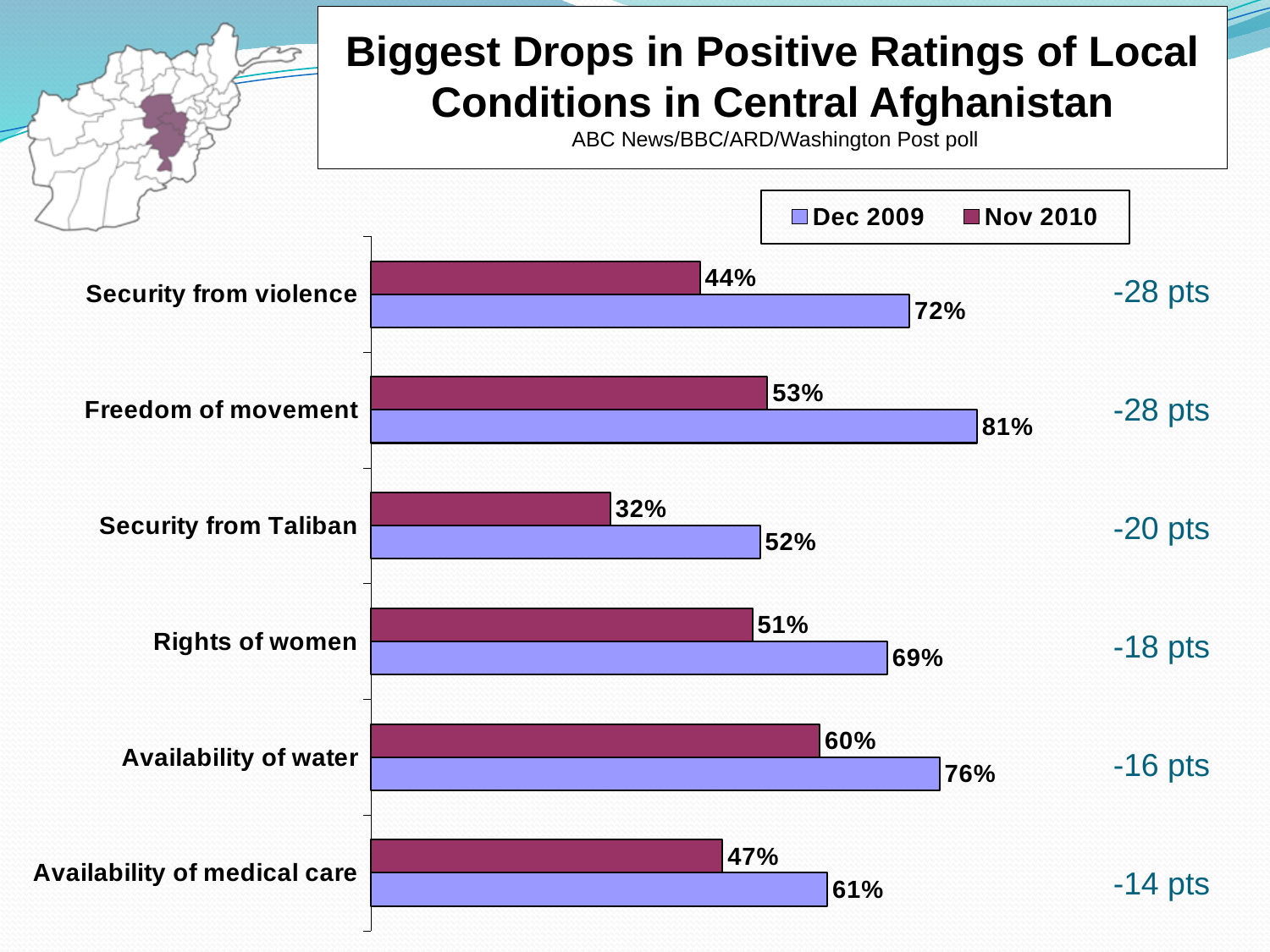
What kind of chart is shown on the slide? Bar chart What is the Nov 2010 value for Availability of water? 60% How many categories are shown in the chart? 6 What is the Dec 2009 value for Availability of medical care? 61% Which category has the lowest Nov 2010 value? Security from Taliban How many series does the legend list? 2 What is the Dec 2009 value for Freedom of movement? 81% Which poll is credited as the source of the chart? ABC News/BBC/ARD/Washington Post poll Which is larger: the Nov 2010 value for Freedom of movement or the Nov 2010 value for Rights of women? Freedom of movement What is the Nov 2010 value for Security from violence? 44% What is the difference between the Dec 2009 and Nov 2010 values for Rights of women? 18 pts Which category has the highest Dec 2009 value? Freedom of movement